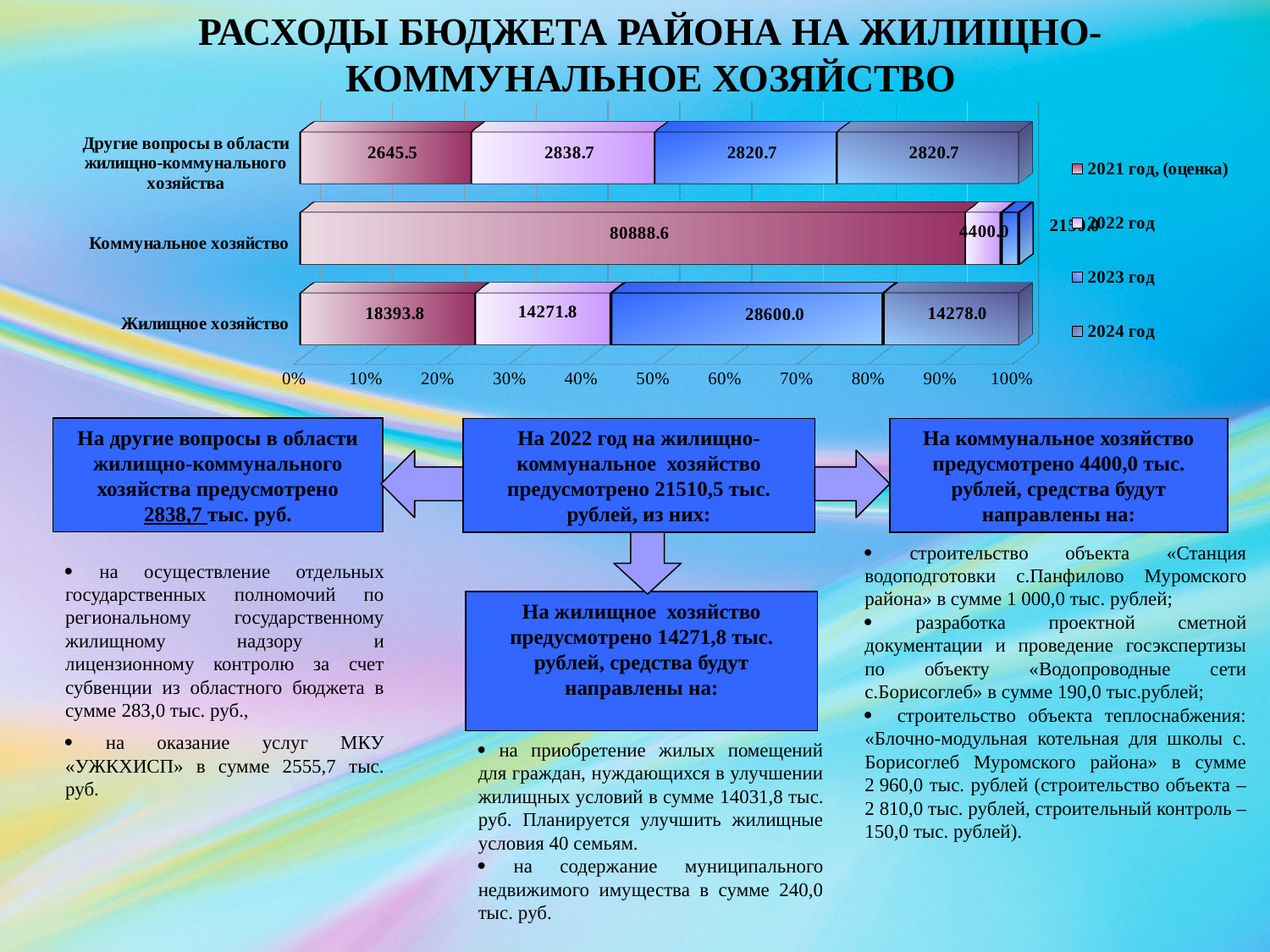
What is the value for 2024 год in the category Жилищное хозяйство? 14278.0 What is the difference between the 2023 год and 2022 год values in the category Жилищное хозяйство? 14328.2 How many categories are shown on the chart's vertical axis? 3 What is the value for 2021 год (оценка) in the category Коммунальное хозяйство? 80888.6 What is the value for 2021 год (оценка) in the category Другие вопросы в области жилищно-коммунального хозяйства? 2645.5 What type of chart is shown on the slide? bar chart What is the total of the four values in the category Другие вопросы в области жилищно-коммунального хозяйства? 11125.6 What is the value for 2022 год in the category Жилищное хозяйство? 14271.8 Which year has the highest value in the category Жилищное хозяйство? 2023 год How many series does the chart legend list? 4 In the category Другие вопросы в области жилищно-коммунального хозяйства, which is larger: the value for 2021 год (оценка) or for 2022 год? 2022 год Which year has the lowest value in the category Другие вопросы в области жилищно-коммунального хозяйства? 2021 год (оценка)